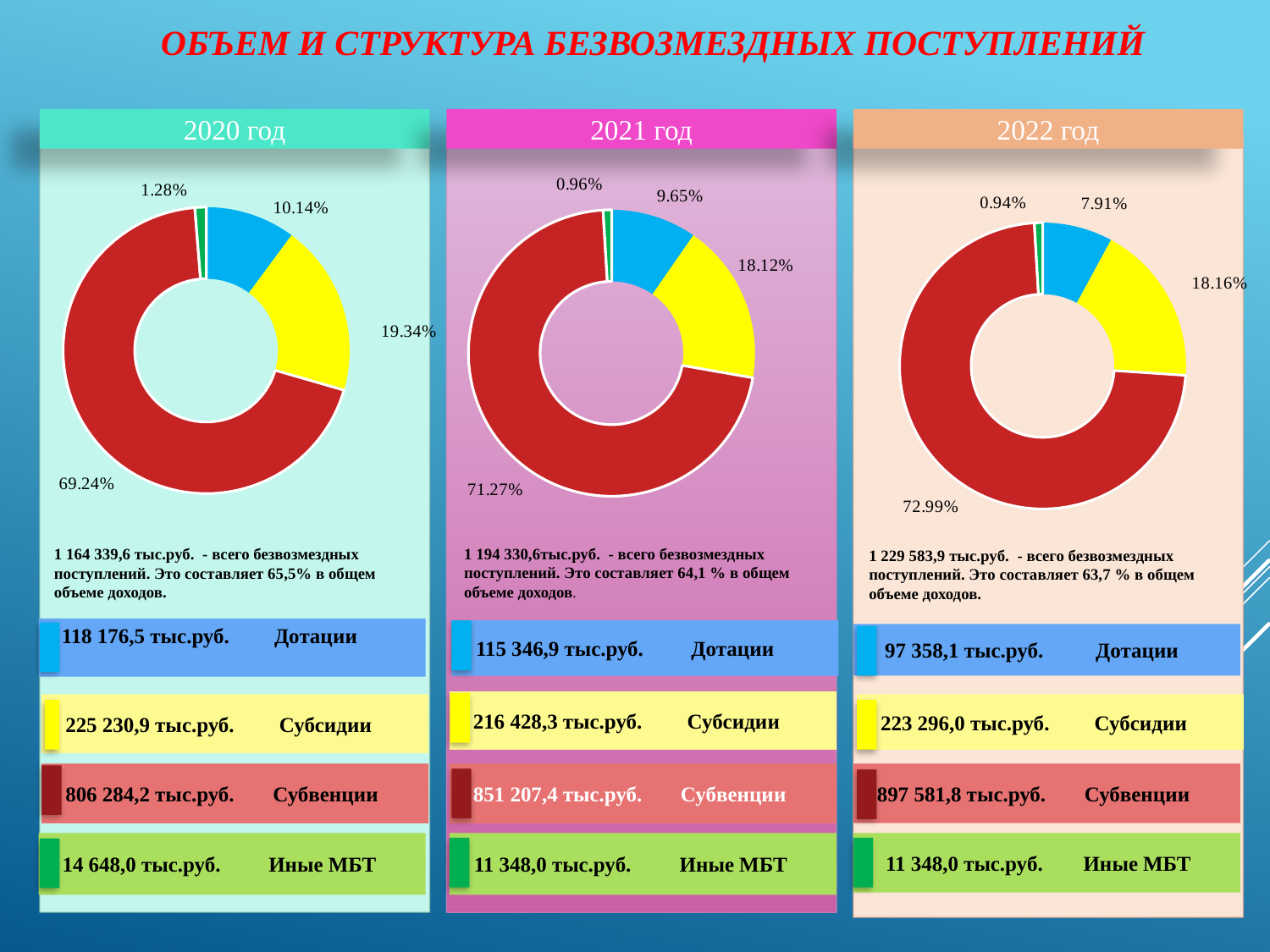
In the 2022 год chart, what share does the yellow slice (Субсидии) have? 18.16% In the 2021 год chart, which slice is the largest? Субвенции (71.27%) Which is larger in the 2020 год chart: the blue slice (10.14%) or the yellow slice (19.34%)? The yellow slice (19.34%) In the 2021 год chart, what share does the blue slice (Дотации) have? 9.65% In the 2020 год chart, what share does the largest (red) slice have? 69.24% How many slices does the 2020 год doughnut chart have? 4 What is the difference between the red slice shares in the 2022 год chart (72.99%) and the 2020 год chart (69.24%)? 3.75 percentage points What kind of chart is used for the 2020 год panel? Doughnut (pie) chart Does the share of the red slice (Субвенции) rise or fall from the 2020 год chart to the 2022 год chart? Rise In the 2022 год chart, which slice is the smallest? Иные МБТ (0.94%) Which category does the red colour represent in the legend below the charts? Субвенции